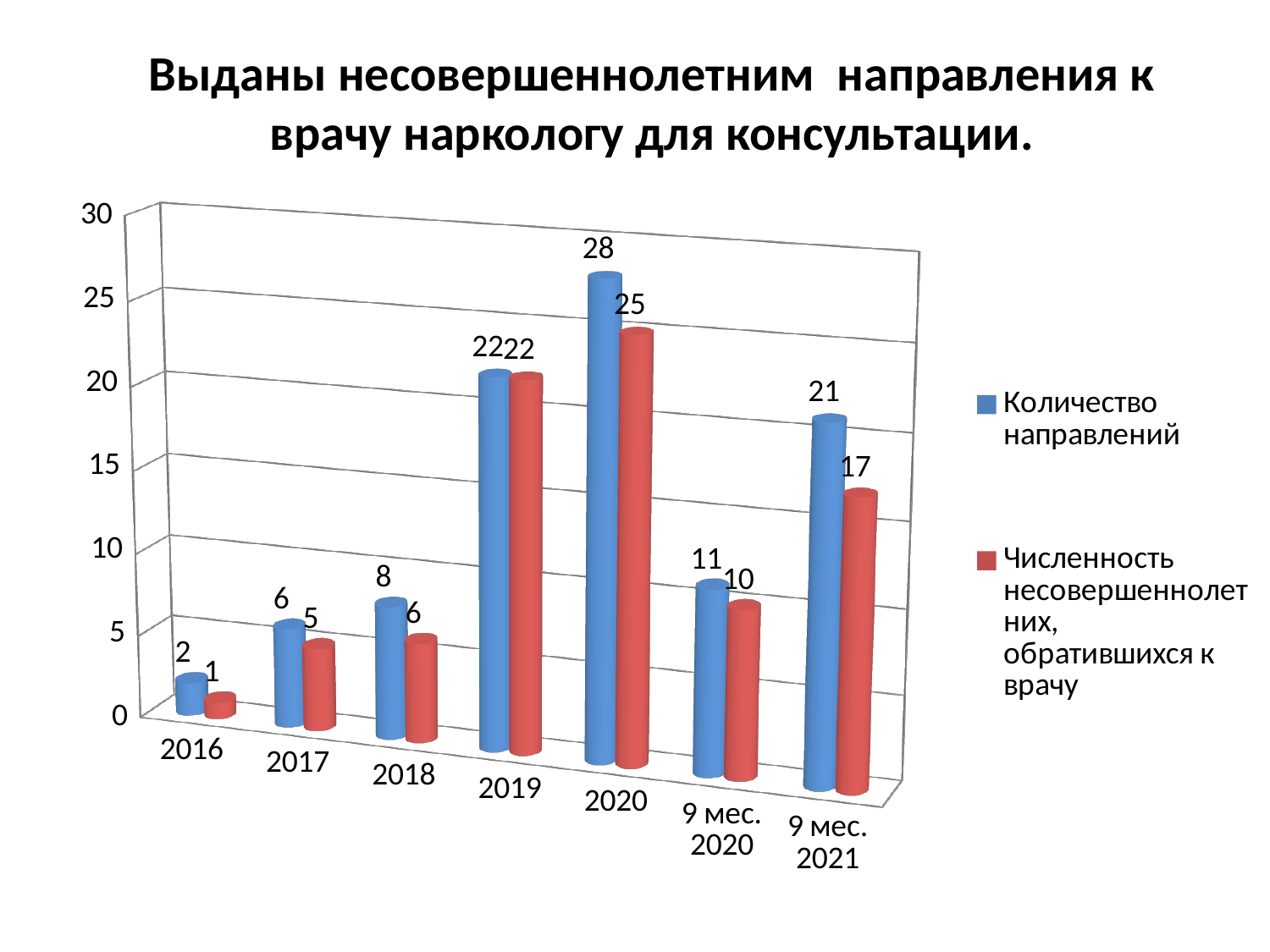
What colour are the bars for "Численность несовершеннолетних, обратившихся к врачу"? Red What kind of chart is shown on the slide? Bar chart Which category has the highest value for "Количество направлений"? 2020 Does "Количество направлений" rise or fall from 2016 to 2020? Rise What is the value of "Количество направлений" for 2020? 28 What is the difference between "Количество направлений" and "Численность несовершеннолетних, обратившихся к врачу" for 9 мес. 2021? 4 How many categories are shown on the x axis? 7 What is the value of "Численность несовершеннолетних, обратившихся к врачу" for 2016? 1 Which category has the lowest value for "Численность несовершеннолетних, обратившихся к врачу"? 2016 How many series does the legend list? 2 What is the value of "Численность несовершеннолетних, обратившихся к врачу" for 9 мес. 2021? 17 Which is larger: "Количество направлений" for 2019 or for 9 мес. 2020? 2019